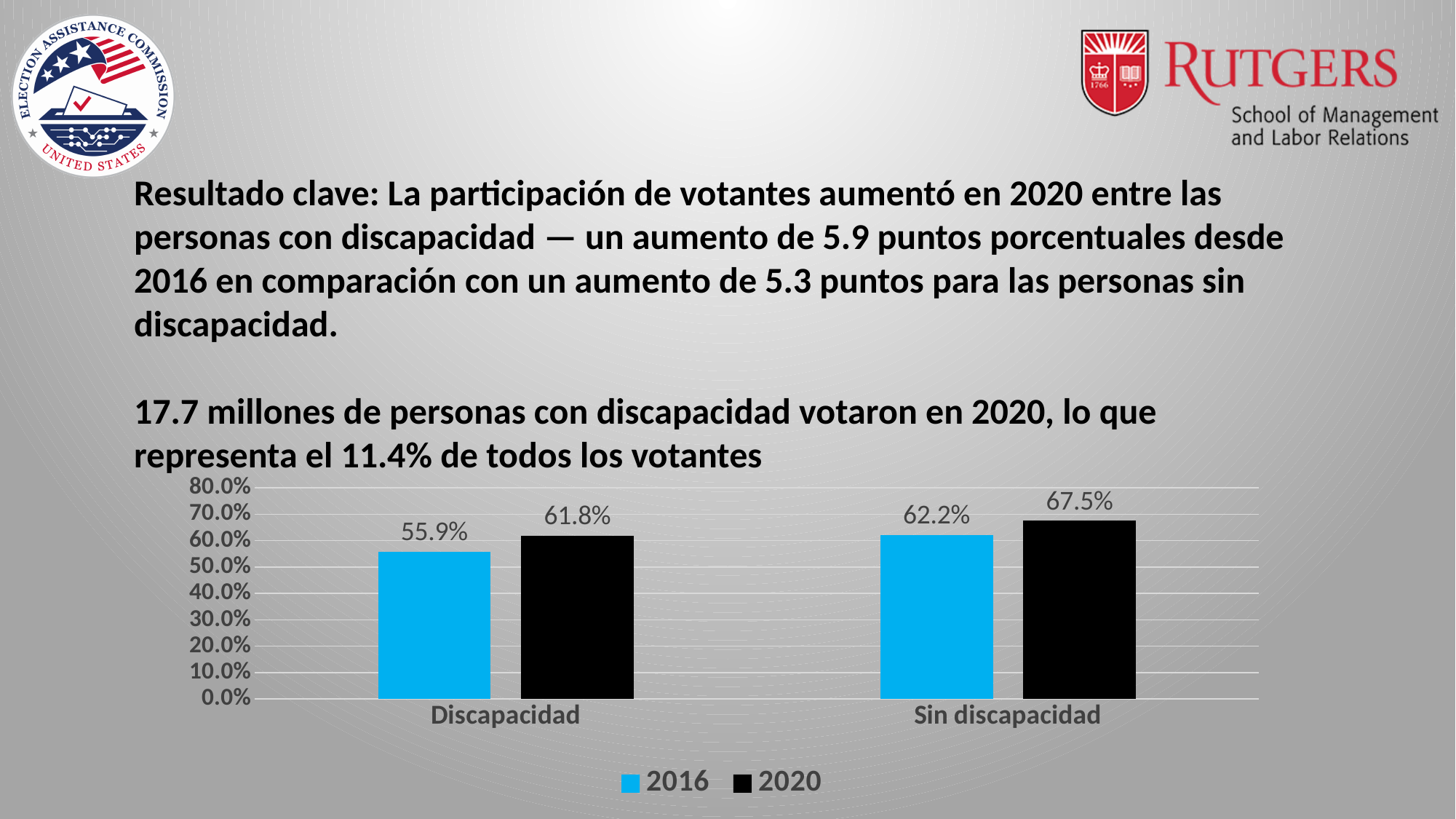
What was the 2016 value for Sin discapacidad? 62.2% What kind of chart is shown on the slide? Bar chart By how many percentage points did the value for Discapacidad change from 2016 to 2020? 5.9 Which bar in the chart has the highest value? Sin discapacidad, 2020 What was the 2020 value for Discapacidad? 61.8% What was the 2016 value for Discapacidad? 55.9% Which is larger: the 2020 value for Discapacidad or the 2016 value for Sin discapacidad? 2016 value for Sin discapacidad Which bar in the chart has the lowest value? Discapacidad, 2016 Which colour represents the 2016 series in the chart? Blue What was the 2020 value for Sin discapacidad? 67.5% By how many percentage points did the value for Sin discapacidad change from 2016 to 2020? 5.3 How many series does the legend list? 2